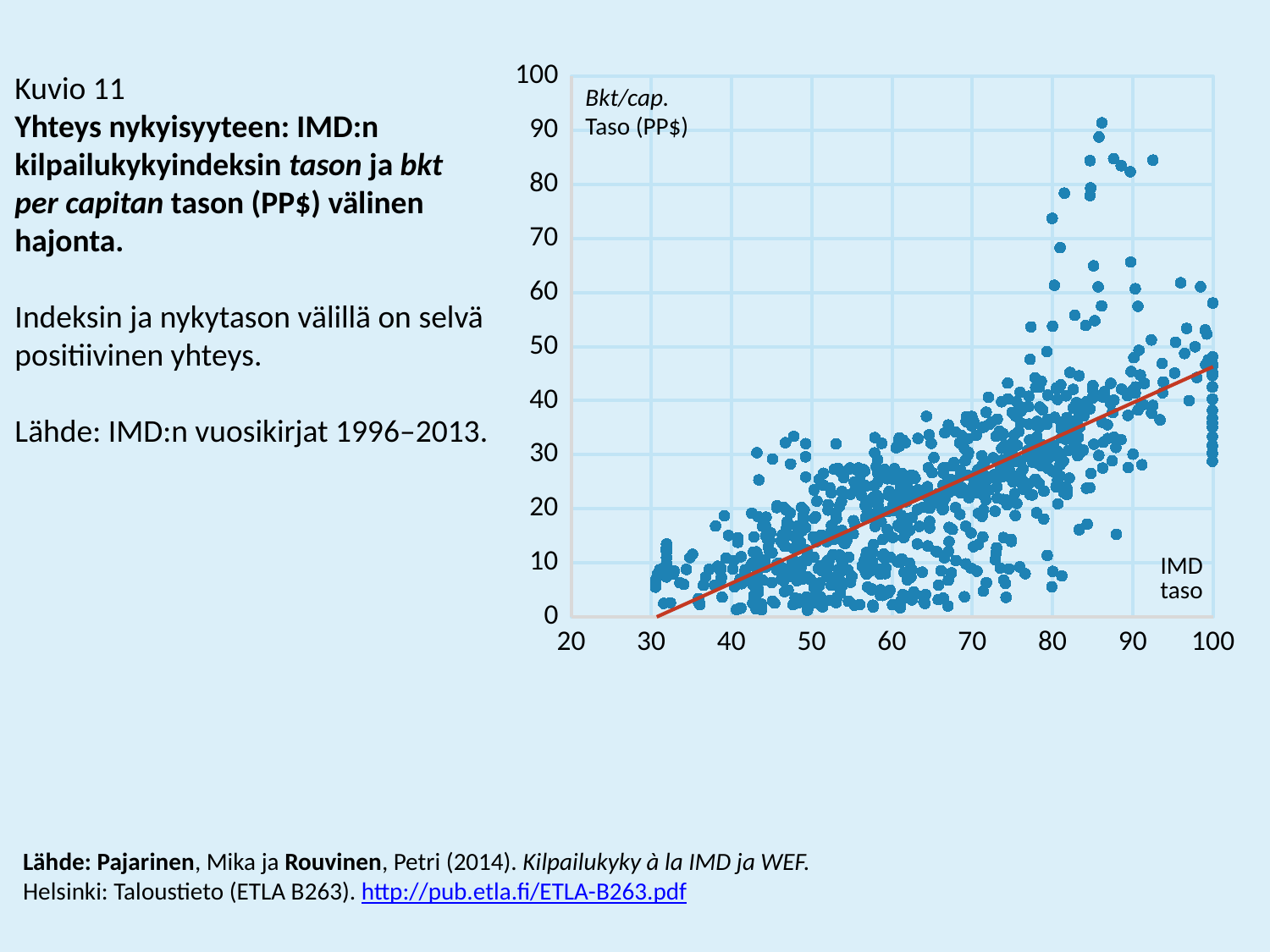
What is the highest value shown on the y axis of the chart? 100 Is the value of the red trend line at an IMD taso of 40 greater or less than 20? less Is the value of the red trend line at an IMD taso of 100 greater or less than 40? greater What is the highest value shown on the x axis of the chart? 100 What is the label of the y axis of the chart? Bkt/cap. Taso (PP$) What is the lowest value shown on the x axis of the chart? 20 Does the red trend line slope upward or downward from left to right? Upward What is the label of the x axis of the chart? IMD taso What kind of chart is shown on the slide? Scatter plot Do the plotted values generally rise or fall as the IMD taso increases along the x axis? Rise Is the y value of the highest plotted point greater or less than 80? greater